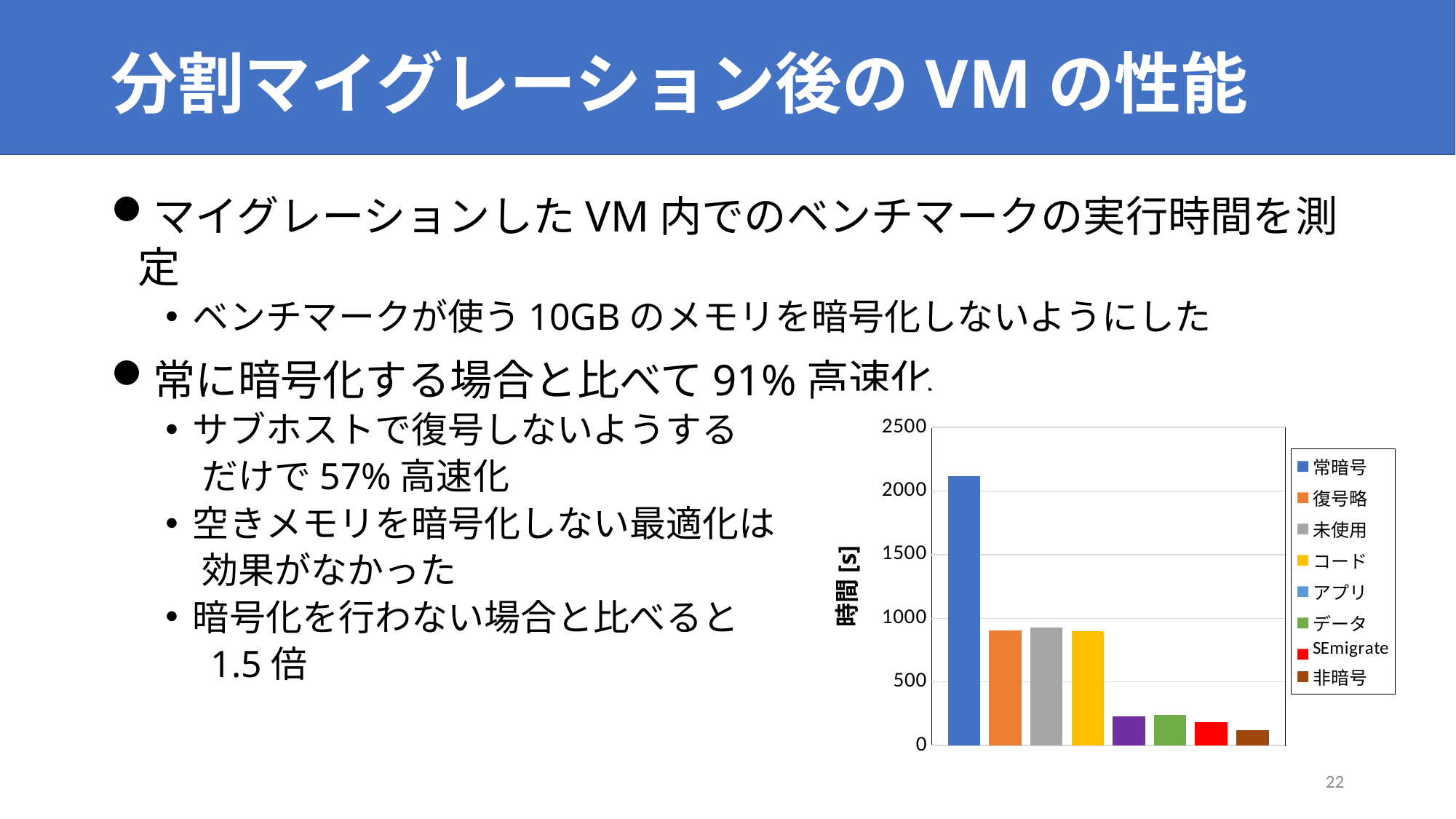
Is the value for SEmigrate greater or less than 500? less Is the value for 常暗号 greater or less than 2000? greater What kind of chart is shown on the slide? bar chart Is the value for 復号略 greater or less than 1000? less How many series does the chart legend list? 8 Which is larger, the value for 常暗号 or the value for コード? 常暗号 What is the label of the vertical axis of the chart? 時間 [s] Which series has the highest value in the chart? 常暗号 Which is larger, the value for 未使用 or the value for 非暗号? 未使用 Which series has the lowest value in the chart? 非暗号 What is the highest tick value shown on the vertical axis? 2500